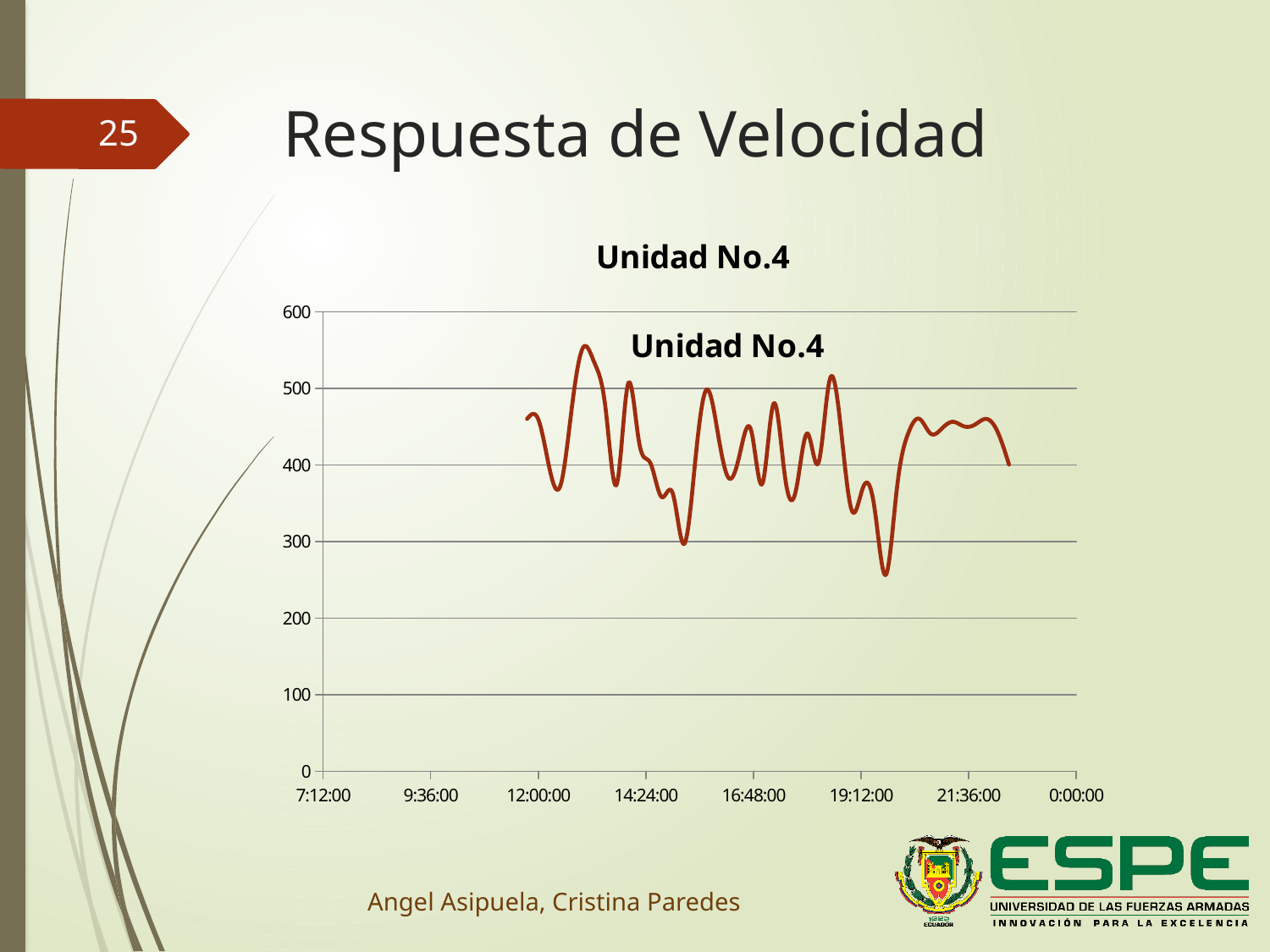
Does the Unidad No.4 line ever drop below 200? No How many data series does the chart plot? 1 What kind of chart is shown on the slide? line chart What is the first time label on the horizontal axis? 7:12:00 What is the highest value shown on the vertical axis? 600 Is the value of the Unidad No.4 line at 12:00:00 greater or less than 400? greater What is the title of the chart? Unidad No.4 Does the Unidad No.4 line ever exceed 600? No How many time labels are shown on the horizontal axis? 8